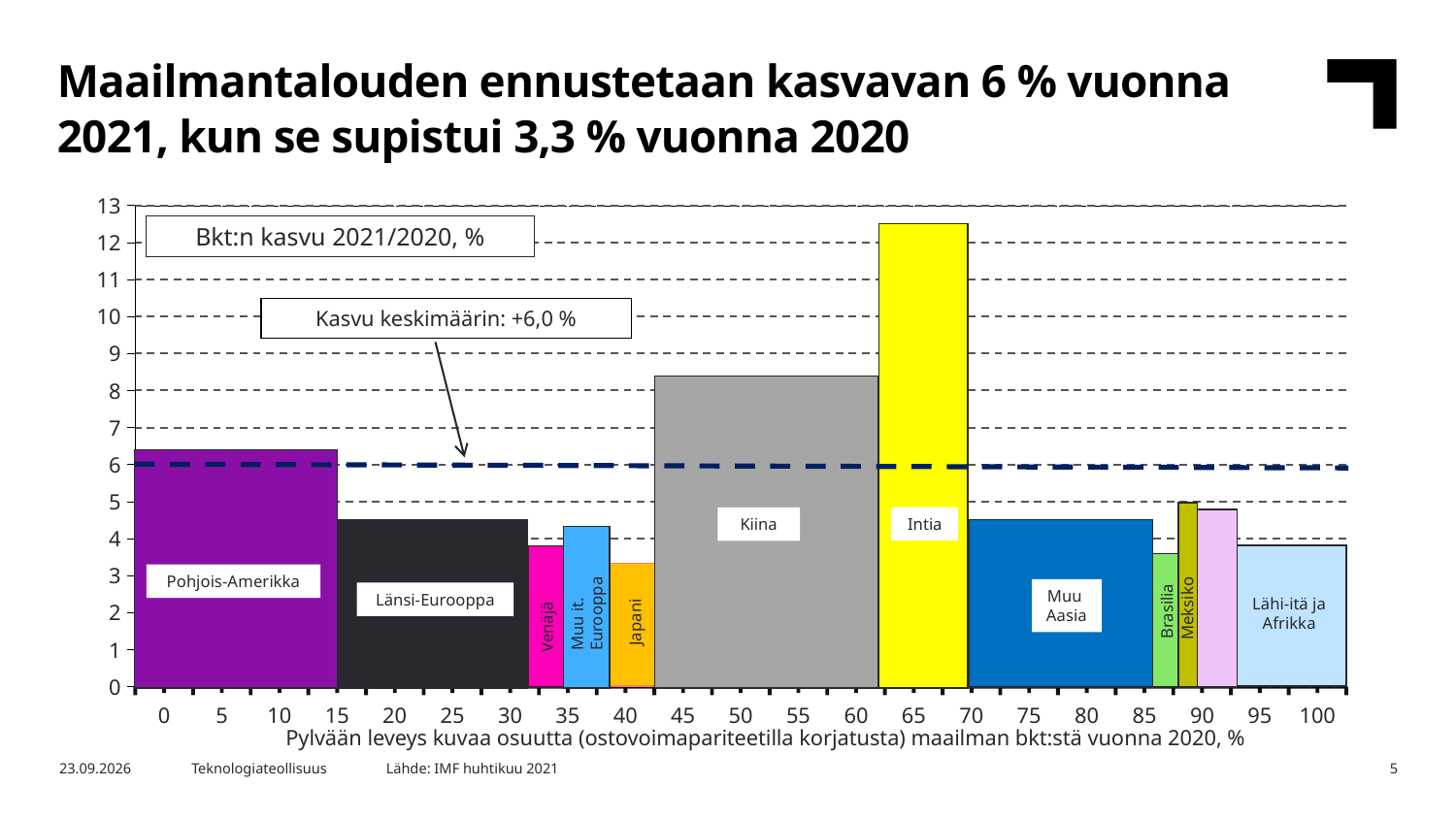
Which has the higher GDP growth, Kiina or Pohjois-Amerikka? Kiina Is the value for Japani greater or less than 4? less What average growth value is printed on the chart? +6,0 % Is the value for Länsi-Eurooppa greater or less than 5? less Which has the higher GDP growth, Meksiko or Brasilia? Meksiko How many regions are shown as bars in the chart? 11 Is the value for Intia greater or less than 12? greater What is the title shown in the box at the top of the chart? Bkt:n kasvu 2021/2020, % Which region has the highest GDP growth in the chart? Intia What kind of chart is shown on the slide? bar chart